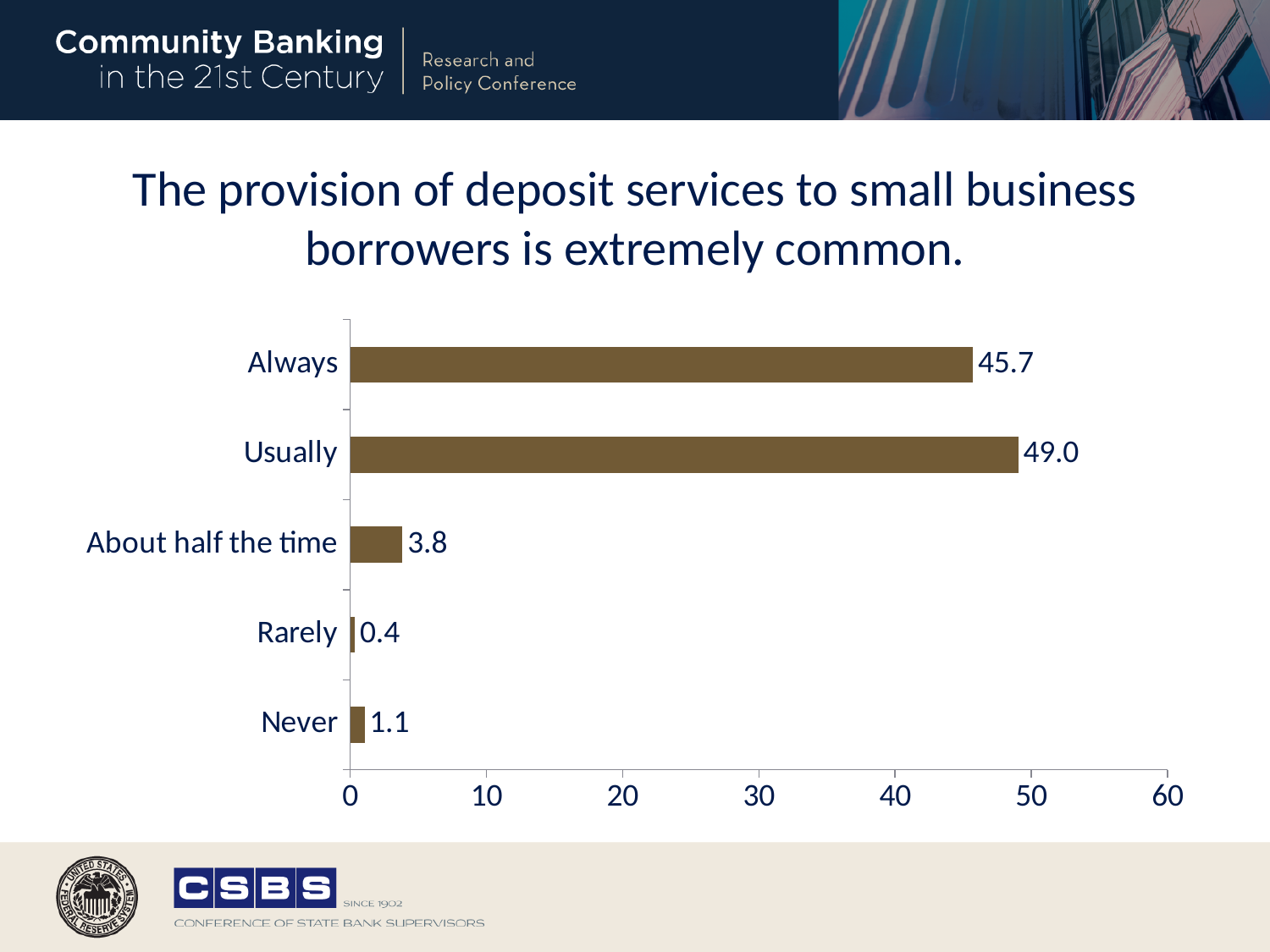
Which is larger, the value for Never or the value for Rarely? Never What is the value for Never? 1.1 What kind of chart is shown on the slide? Bar chart What is the value for About half the time? 3.8 What is the difference between the values for Usually and Always? 3.3 Which category has the lowest value? Rarely Is the value for Always greater or less than 40? greater How many categories are shown in the chart? 5 What is the value for Usually? 49.0 What is the value for Rarely? 0.4 Which category has the highest value? Usually What is the value for Always? 45.7